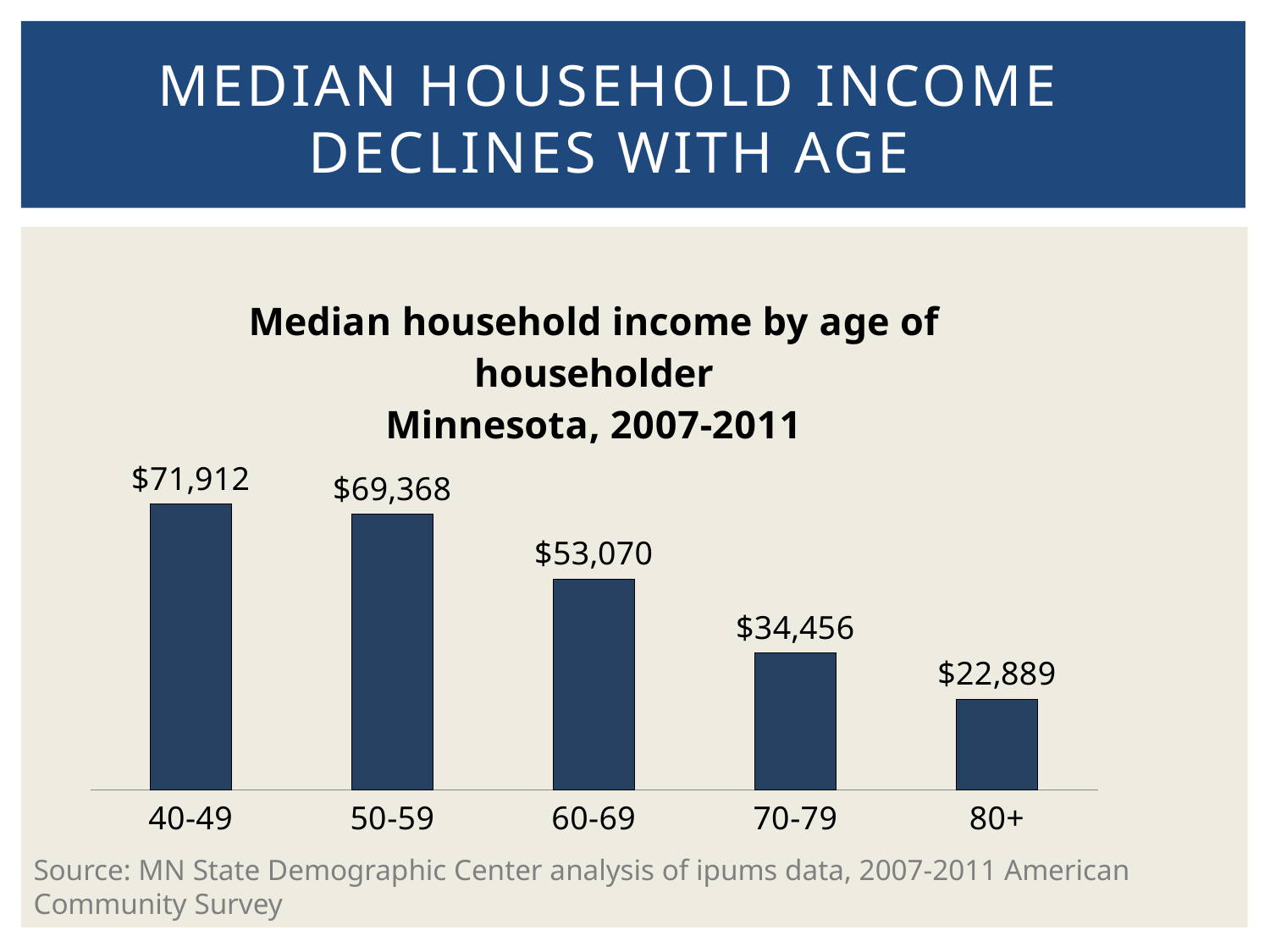
Which age group has the highest median household income? 40-49 What is the median household income for the 40-49 age group? $71,912 What is the difference in median household income between the 70-79 and 80+ age groups? $11,567 Do median household income values rise or fall as age group increases along the x axis? Fall What is the median household income for the 60-69 age group? $53,070 What is the title of the chart? Median household income by age of householder Minnesota, 2007-2011 What is the median household income for the 80+ age group? $22,889 How many age groups are shown in the chart? 5 Which age group has the lowest median household income? 80+ Which age group has a higher median household income, 60-69 or 70-79? 60-69 What kind of chart is shown on the slide? Bar chart What is the difference in median household income between the 40-49 and 50-59 age groups? $2,544